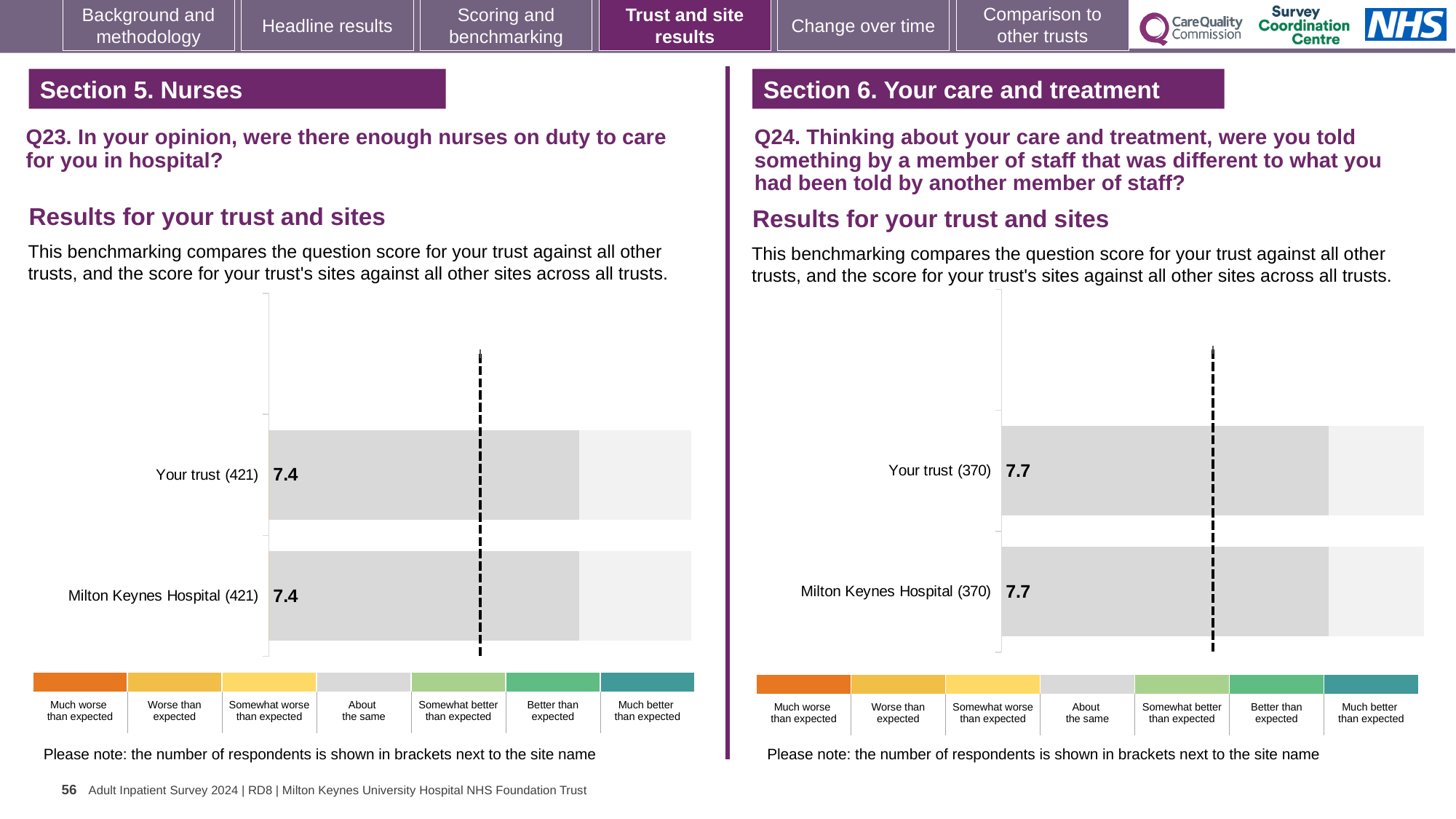
On the right chart (Q24), what is the score for Milton Keynes Hospital? 7.7 On the left chart (Q23), how many respondents are shown in brackets for Your trust? 421 What kind of chart is used on the left side of the slide for Q23? Bar chart On the left chart (Q23), which category does the colour key place both bars in? About the same On the left chart (Q23), what is the score for Milton Keynes Hospital? 7.4 On the left chart (Q23, enough nurses on duty), what is the score for Your trust? 7.4 On the right chart (Q24), how many respondents are shown in brackets for Milton Keynes Hospital? 370 On the right chart (Q24, told something different by staff), what is the score for Your trust? 7.7 On the left chart (Q23), what is the difference between the score for Your trust and the score for Milton Keynes Hospital? 0 How many bars are plotted on the left chart (Q23)? 2 How many bars are plotted on the right chart (Q24)? 2 On the right chart (Q24), what is the difference between the score for Your trust and the score for Milton Keynes Hospital? 0